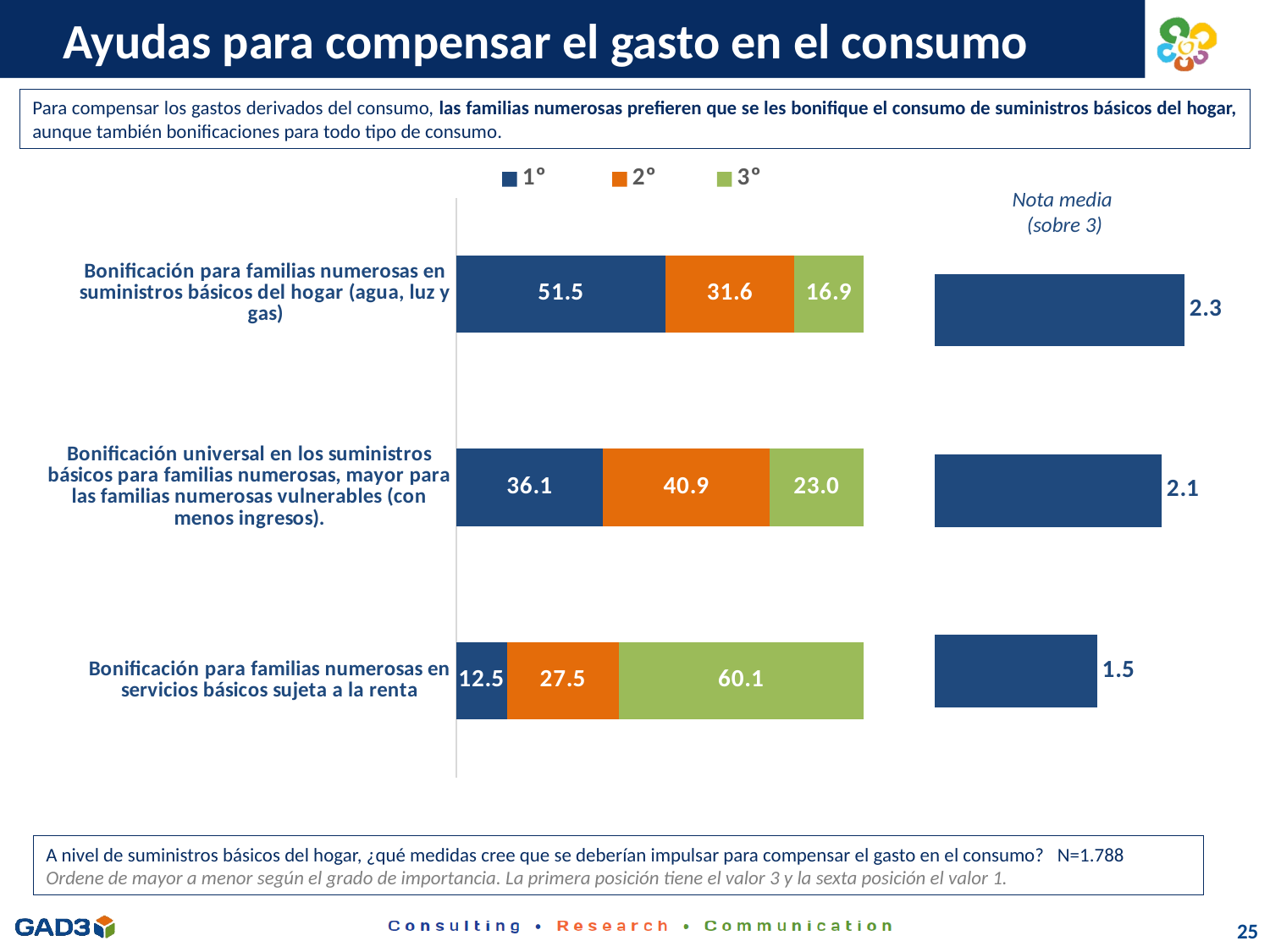
In the stacked bar chart on the left, what is the value of the 1° series for 'Bonificación para familias numerosas en suministros básicos del hogar (agua, luz y gas)'? 51.5 In the stacked bar chart on the left, what is the value of the 2° series for 'Bonificación universal en los suministros básicos para familias numerosas, mayor para las familias numerosas vulnerables (con menos ingresos)'? 40.9 How many series does the legend of the stacked bar chart on the left list? 3 In the 'Nota media (sobre 3)' chart on the right, which category has the highest value? Bonificación para familias numerosas en suministros básicos del hogar (agua, luz y gas) In the stacked bar chart on the left, what is the value of the 3° series for 'Bonificación para familias numerosas en servicios básicos sujeta a la renta'? 60.1 In the stacked bar chart on the left, which is larger for 'Bonificación universal en los suministros básicos para familias numerosas...': the 1° value or the 2° value? 2° How many categories are shown in the stacked bar chart on the left? 3 In the stacked bar chart on the left, which category has the lowest 1° value? Bonificación para familias numerosas en servicios básicos sujeta a la renta In the stacked bar chart on the left, what is the difference between the 1° and 2° values for 'Bonificación para familias numerosas en suministros básicos del hogar (agua, luz y gas)'? 19.9 In the 'Nota media (sobre 3)' chart on the right, what is the value for 'Bonificación para familias numerosas en servicios básicos sujeta a la renta'? 1.5 What type of chart is the 'Nota media (sobre 3)' chart on the right? Bar chart In the stacked bar chart on the left, which category has the highest 1° value? Bonificación para familias numerosas en suministros básicos del hogar (agua, luz y gas)